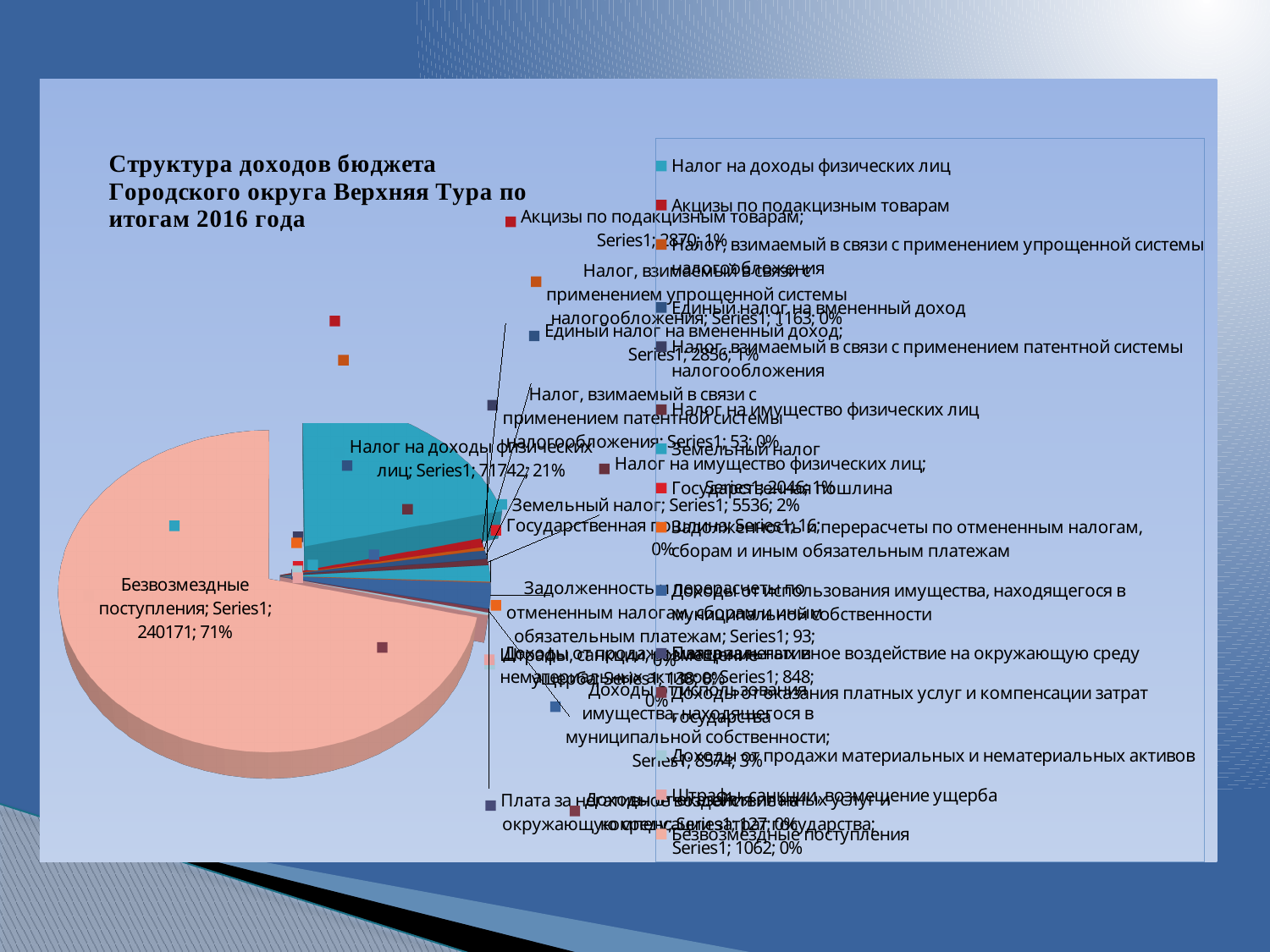
What is the value shown for Земельный налог? 5536 What is the value shown for Налог на доходы физических лиц? 71742 What share of the pie does Налог на доходы физических лиц take? 21% Which is larger: the value for Земельный налог or the value for Доходы от использования имущества, находящегося в муниципальной собственности? Доходы от использования имущества, находящегося в муниципальной собственности How many categories does the legend list? 15 What kind of chart is shown on the slide? Pie chart What is the value shown for Доходы от использования имущества, находящегося в муниципальной собственности? 8574 What is the value shown for Безвозмездные поступления? 240171 Which category has the largest slice of the pie? Безвозмездные поступления What is the difference between the values for Безвозмездные поступления and Налог на доходы физических лиц? 168429 What share of the pie does Безвозмездные поступления take? 71% What is the title of the chart? Структура доходов бюджета Городского округа Верхняя Тура по итогам 2016 года